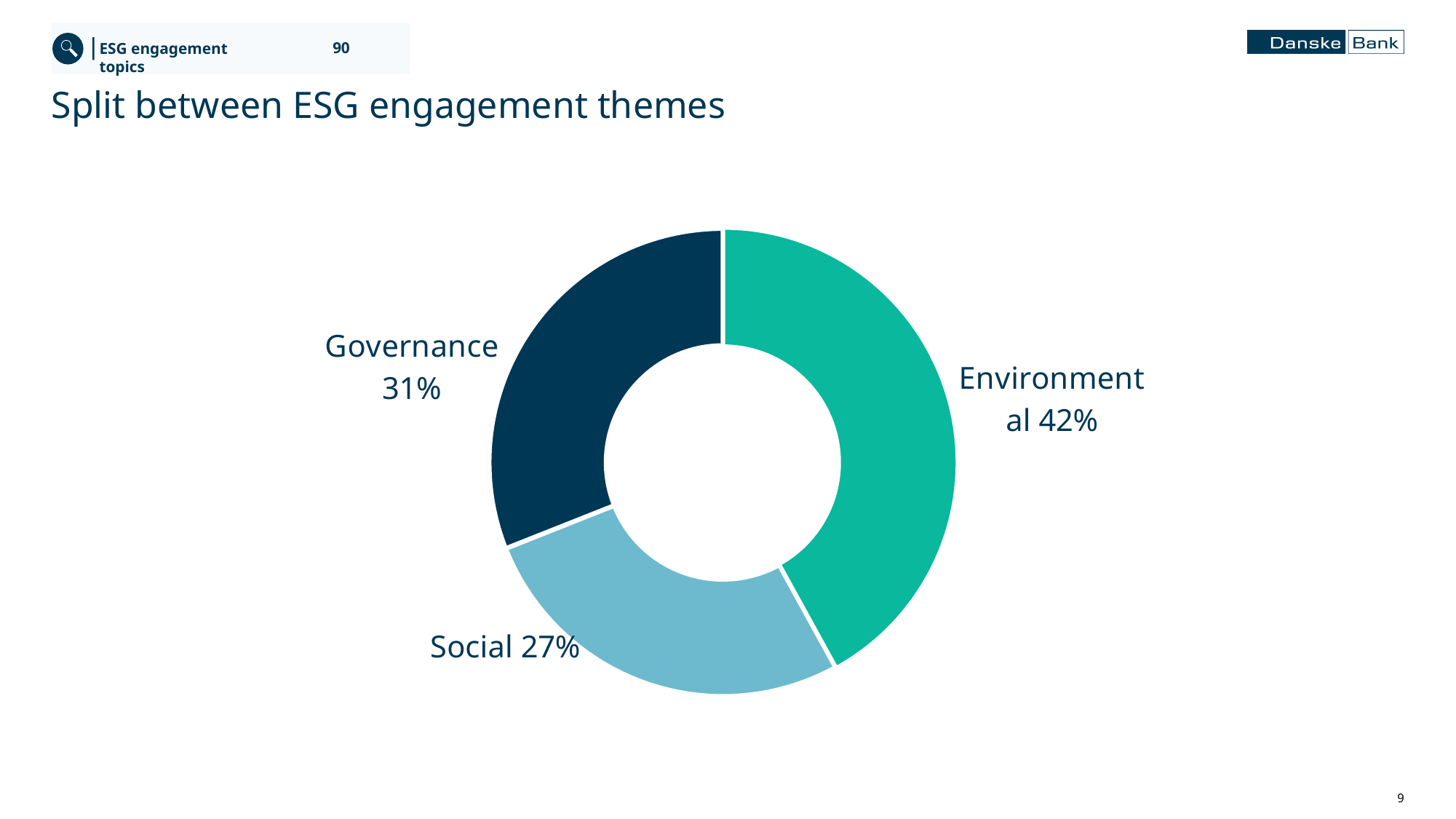
What share of ESG engagement themes is Governance? 31% What colour is the Social slice of the chart? Light blue What share of ESG engagement themes is Social? 27% What kind of chart is shown on the slide? Pie chart (donut) How many ESG engagement themes are shown in the chart? 3 Which ESG engagement theme has the largest share? Environmental Which has a larger share, Governance or Social? Governance What is the title of the slide? Split between ESG engagement themes What is the difference in percentage points between the Environmental and Social shares? 15 What share of ESG engagement themes is Environmental? 42% Which ESG engagement theme has the smallest share? Social What is the difference in percentage points between the Governance and Social shares? 4